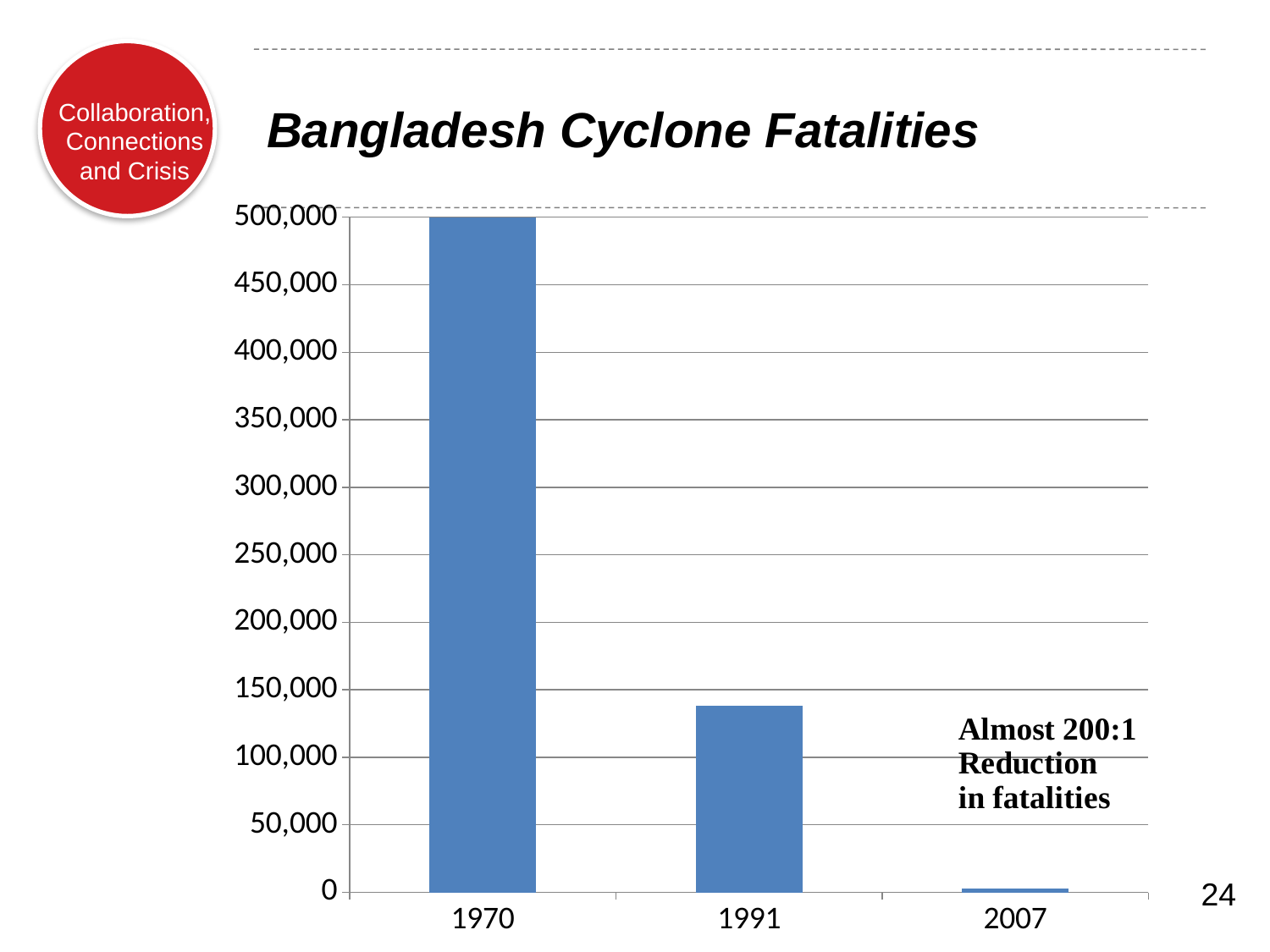
Is the value for 1970 greater or less than 450,000? greater What kind of chart is shown on the slide? bar chart Is the value for 1991 greater or less than 100,000? greater Which year has the highest number of cyclone fatalities? 1970 How many years are shown on the x axis of the chart? 3 Which year has more fatalities, 1991 or 2007? 1991 Which year has the lowest number of cyclone fatalities? 2007 Do the fatalities rise or fall from 1970 to 2007? fall What reduction in fatalities does the annotation on the chart state? Almost 200:1 Is the value for 2007 greater or less than 50,000? less What is the title of the chart? Bangladesh Cyclone Fatalities